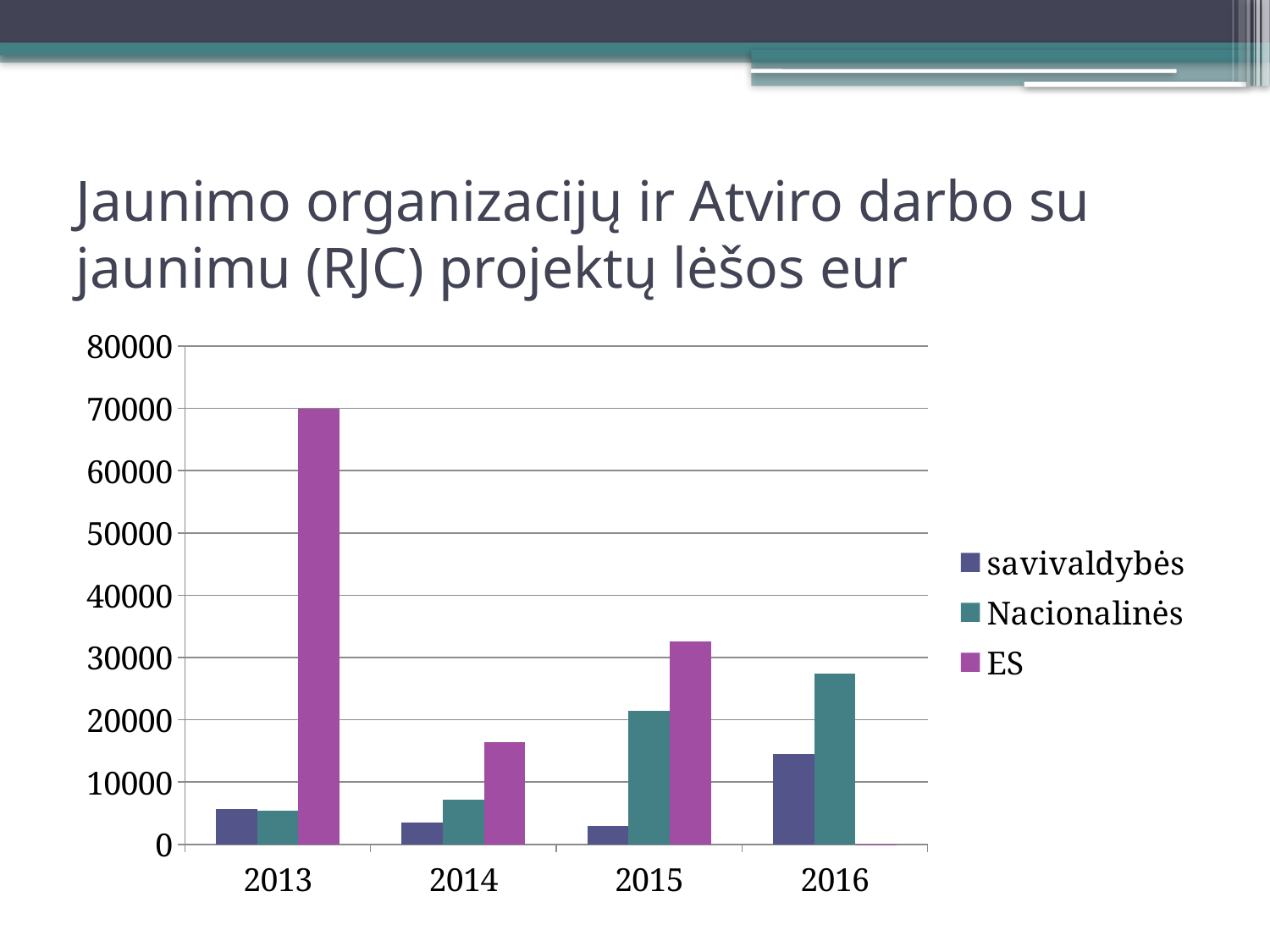
What kind of chart is shown on the slide? bar chart Do the Nacionalinės values rise or fall from 2013 to 2016? rise In 2016, which is larger: savivaldybės or Nacionalinės? Nacionalinės Is the ES value for 2013 greater or less than 60000? greater In 2015, which is larger: Nacionalinės or ES? ES How many series does the legend list? 3 In which year is the ES value highest? 2013 What are the three legend entries of the chart? savivaldybės, Nacionalinės, ES Is the Nacionalinės value for 2016 greater or less than 20000? greater Is the savivaldybės value for 2014 greater or less than 10000? less In which year is the ES value lowest? 2016 How many years are shown on the x axis? 4